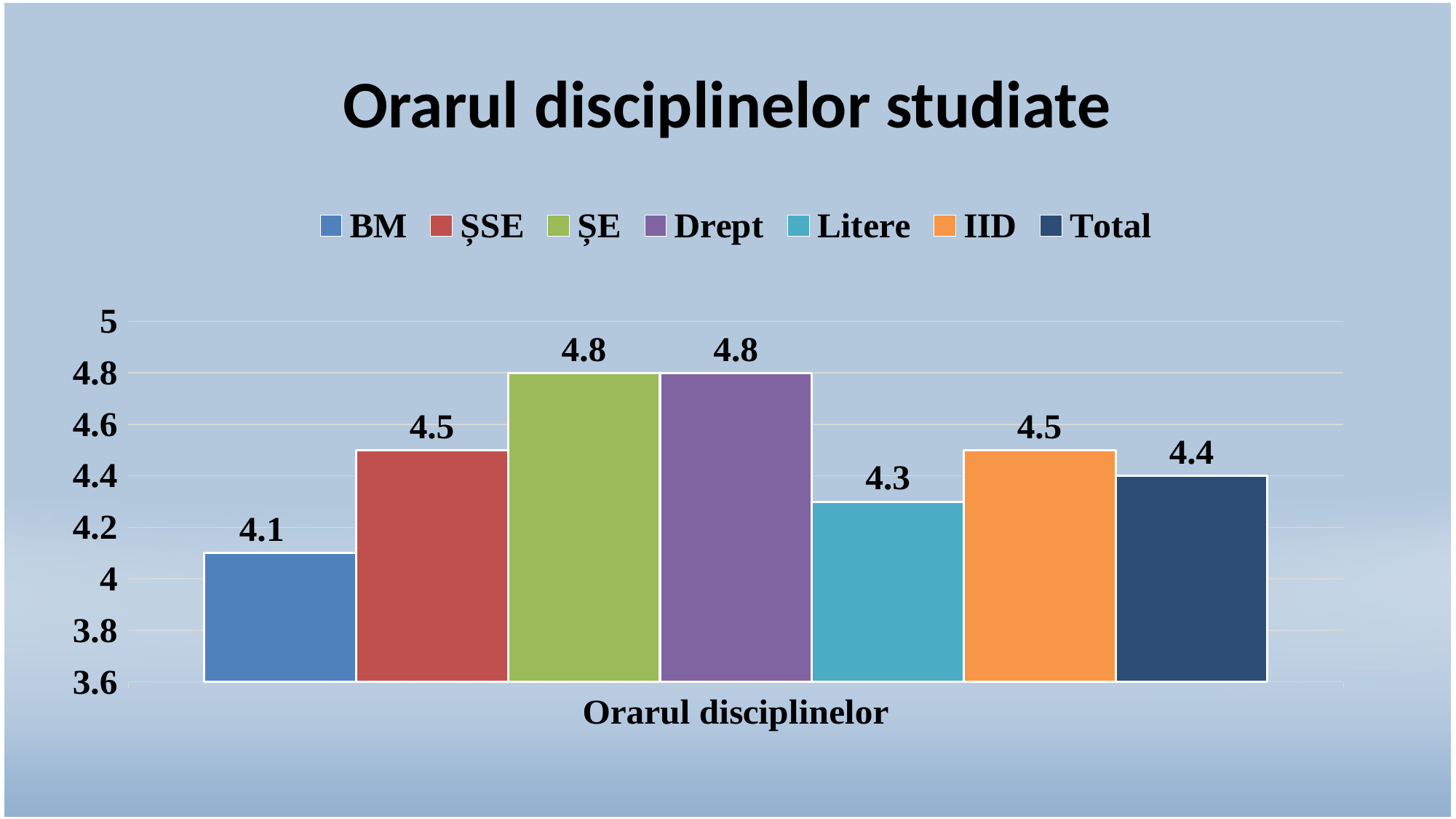
What is the value for BM? 4.1 What is the difference between the values for ȘSE and Litere? 0.2 What is the difference between the values for Drept and BM? 0.7 What kind of chart is shown on the slide? bar chart How many series does the legend list? 7 Which is larger, the value for ȘE or the value for IID? ȘE Which is larger, the value for Litere or the value for Total? Total What is the title of the chart? Orarul disciplinelor studiate Which series has the lowest value? BM What is the value for IID? 4.5 What is the value for Total? 4.4 What is the value for Litere? 4.3